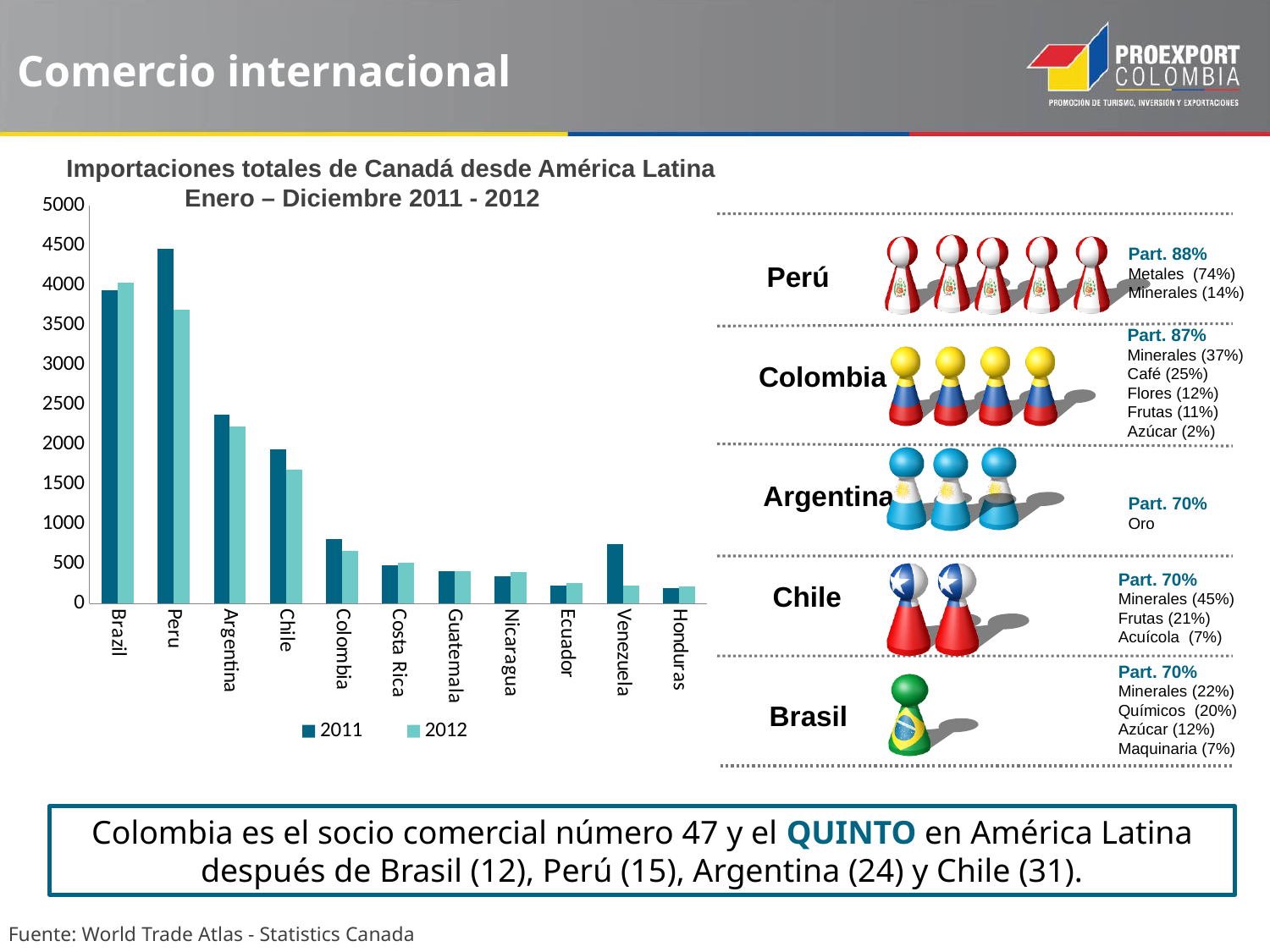
Which country has the highest 2012 value in the chart? Brazil Is the 2011 value for Colombia greater or less than 1000? less How many countries are shown on the x axis of the chart? 11 What kind of chart is shown on the slide? bar chart For Venezuela, which is larger: the 2011 value or the 2012 value? 2011 Which country has the highest 2011 value in the chart? Peru How many series does the chart legend list? 2 Is the 2011 value for Peru greater or less than 4000? greater What are the two entries in the chart legend? 2011 and 2012 Is the 2012 value for Chile greater or less than 1500? greater For Peru, which is larger: the 2011 value or the 2012 value? 2011 Which country has the lowest 2011 value in the chart? Honduras